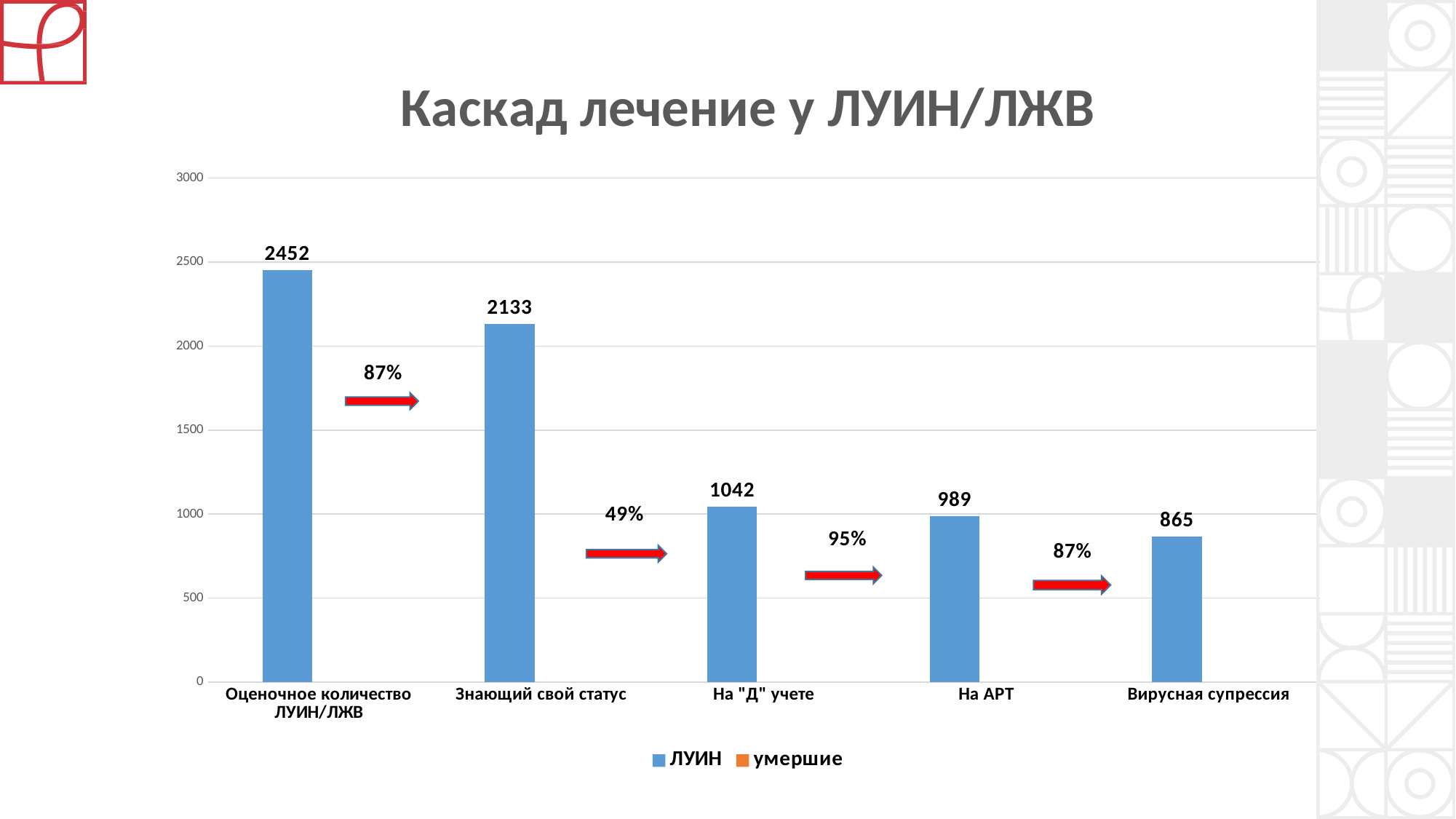
What kind of chart is shown on the slide? bar chart What is the difference between the values for "Оценочное количество ЛУИН/ЛЖВ" and "Знающий свой статус"? 319 Which is larger, the value for "На "Д" учете" or the value for "Вирусная супрессия"? На "Д" учете What is the difference between the values for "На "Д" учете" and "На АРТ"? 53 How many series does the legend list? 2 How many categories are shown on the x axis? 5 Which category has the highest value? Оценочное количество ЛУИН/ЛЖВ What is the value for "На АРТ"? 989 What is the value for "Вирусная супрессия"? 865 Do the bar values rise or fall from left to right along the x axis? fall Which category has the lowest value? Вирусная супрессия What is the value for "Знающий свой статус"? 2133